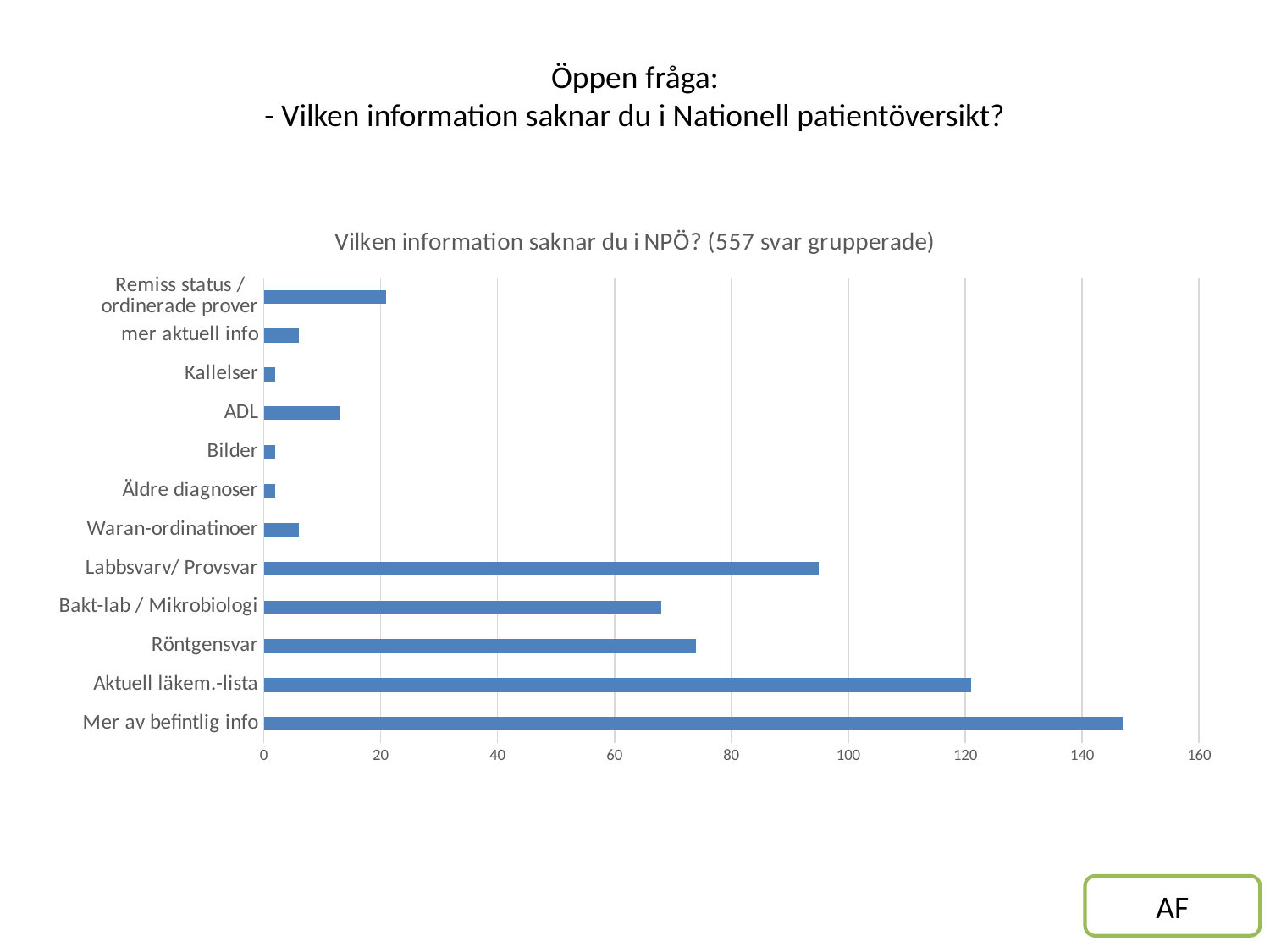
Which category has the highest value? Mer av befintlig info How many categories are plotted in the chart? 12 What is the title of the chart? Vilken information saknar du i NPÖ? (557 svar grupperade) Is the value for Aktuell läkem.-lista greater or less than 100? greater Is the value for Mer av befintlig info greater or less than 140? greater Which is larger, the value for Labbsvarv/ Provsvar or the value for Röntgensvar? Labbsvarv/ Provsvar Is the value for ADL greater or less than 20? less Which is larger, the value for Aktuell läkem.-lista or the value for Bakt-lab / Mikrobiologi? Aktuell läkem.-lista What kind of chart is shown on the slide? Bar chart